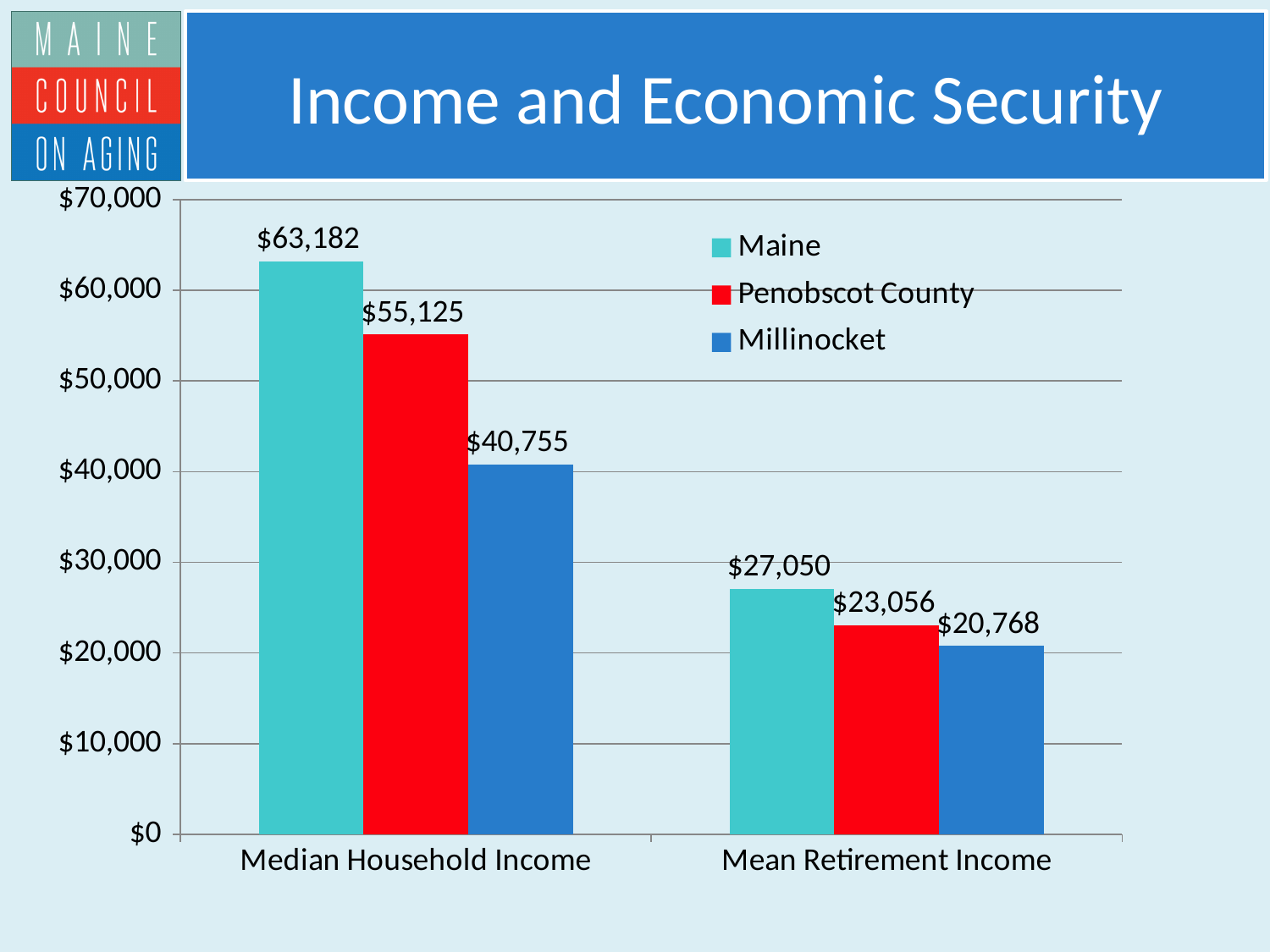
What is the Median Household Income for Penobscot County? $55,125 What is the Mean Retirement Income for Millinocket? $20,768 Is the Median Household Income for Millinocket greater or less than $50,000? less What is the difference between the Mean Retirement Income for Penobscot County and for Millinocket? $2,288 What kind of chart is shown on the slide? bar chart Which series has the highest Median Household Income? Maine How many categories are shown on the x axis? 2 What is the difference between the Median Household Income for Maine and for Millinocket? $22,427 How many series does the legend list? 3 What is the Median Household Income for Maine? $63,182 Which is larger: the Mean Retirement Income for Maine or for Penobscot County? Maine Which series has the lowest Mean Retirement Income? Millinocket